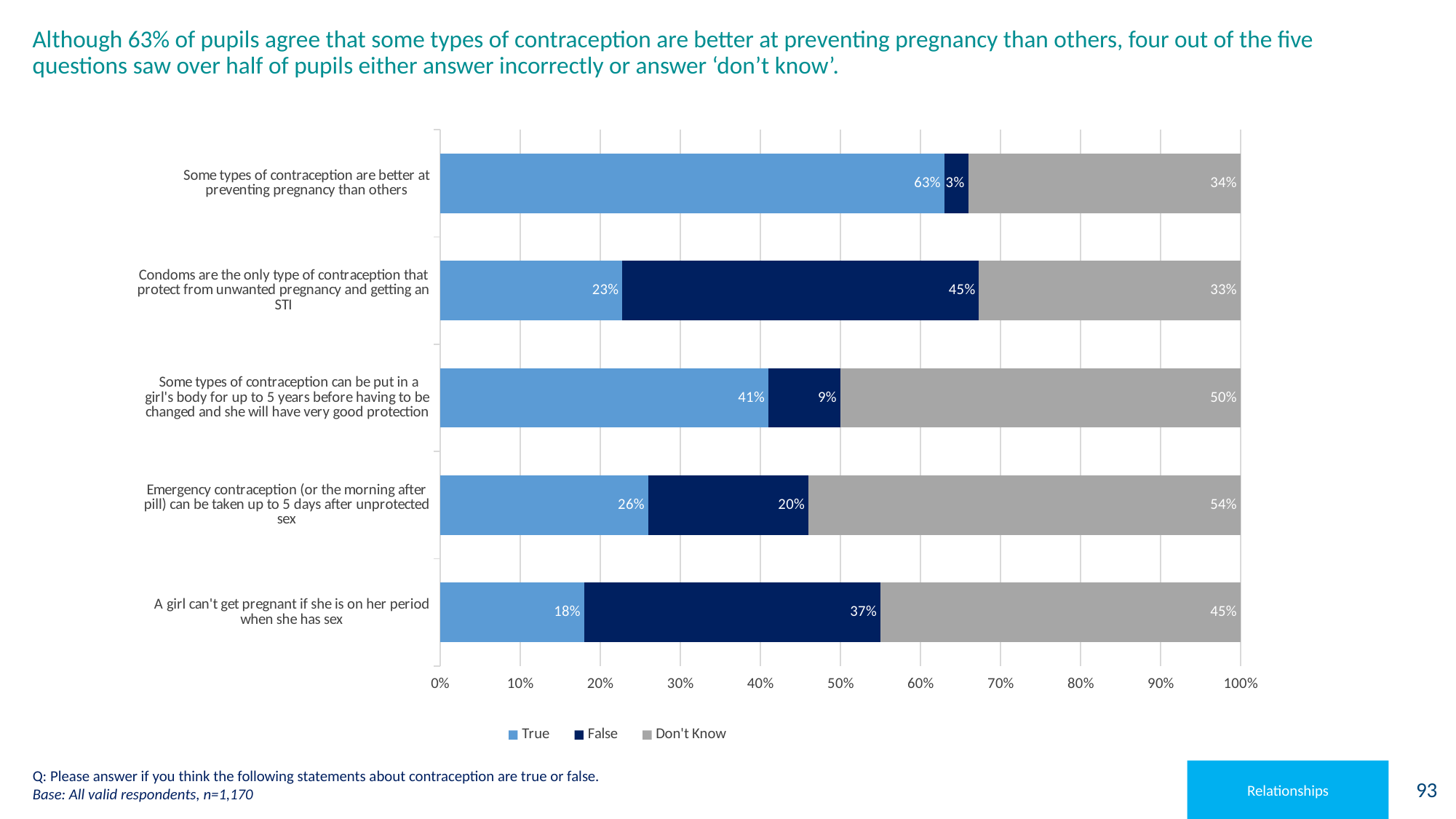
What percentage of pupils answered 'False' to the statement 'Condoms are the only type of contraception that protect from unwanted pregnancy and getting an STI'? 45% For the statement 'Some types of contraception can be put in a girl's body for up to 5 years before having to be changed and she will have very good protection', which is larger: the 'True' share or the 'Don't Know' share? Don't Know What percentage of pupils answered 'True' to the statement 'Some types of contraception are better at preventing pregnancy than others'? 63% What is the difference between the 'False' and 'True' percentages for the statement 'A girl can't get pregnant if she is on her period when she has sex'? 19% What percentage of pupils answered 'Don't Know' to the statement 'Emergency contraception (or the morning after pill) can be taken up to 5 days after unprotected sex'? 54% Which statement has the lowest 'True' percentage? A girl can't get pregnant if she is on her period when she has sex What type of chart is shown on the slide? Stacked bar chart What is the combined 'True' and 'False' percentage for the statement 'Emergency contraception (or the morning after pill) can be taken up to 5 days after unprotected sex'? 46% Which colour represents the 'Don't Know' series in the chart? Grey Which statement has the highest 'Don't Know' percentage? Emergency contraception (or the morning after pill) can be taken up to 5 days after unprotected sex How many series does the legend list? 3 How many statements are shown in the chart? 5